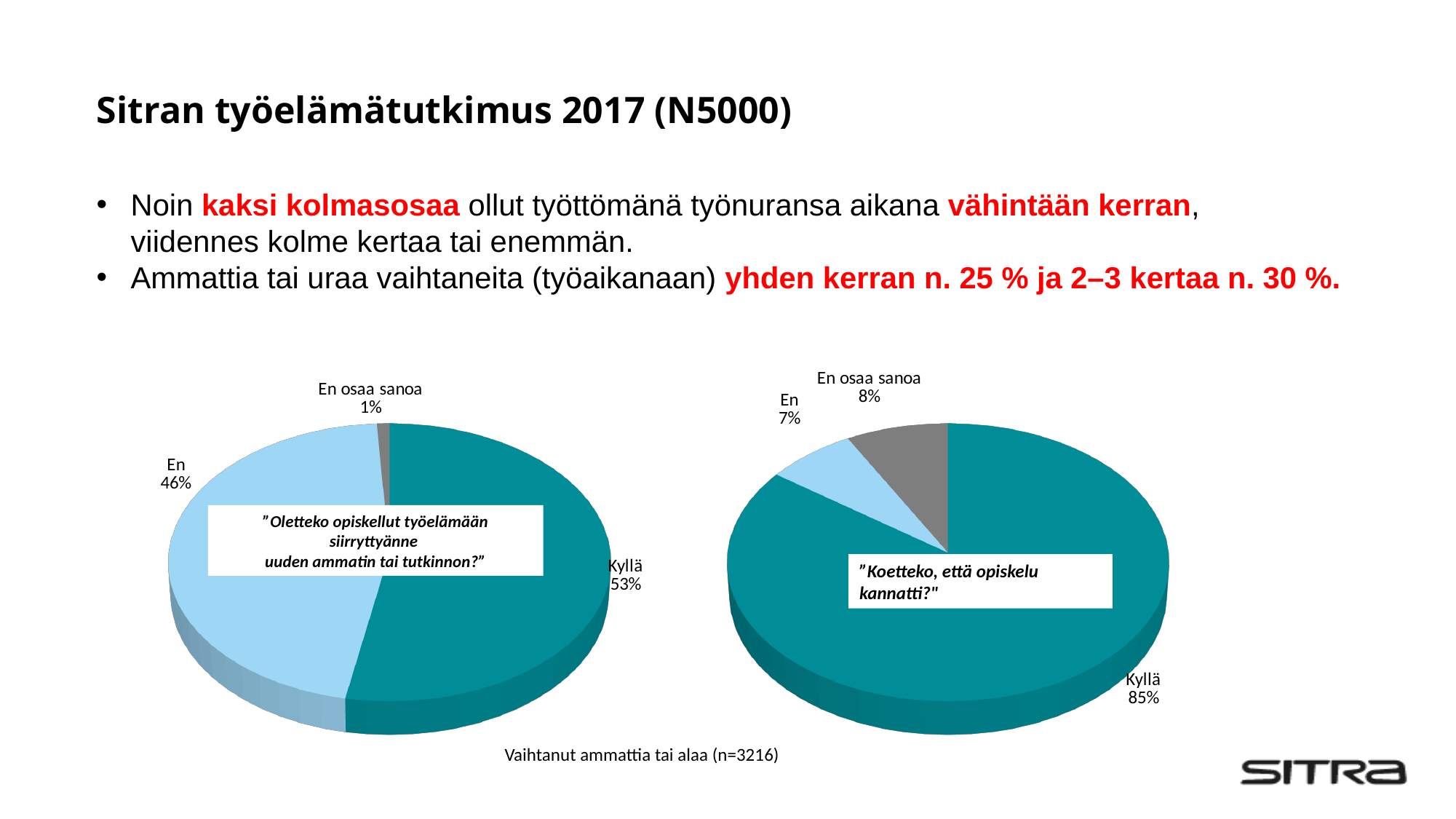
In the right pie chart, which is larger, the En slice or the En osaa sanoa slice? En osaa sanoa In the right pie chart, which category has the largest slice? Kyllä In the right pie chart, what share is labelled En osaa sanoa? 8% How many slices does the right pie chart have? 3 In the right pie chart ("Koetteko, että opiskelu kannatti?"), what share is labelled Kyllä? 85% In the left pie chart, which category has the smallest slice? En osaa sanoa In the left pie chart, what share is labelled En? 46% What type of chart is used on the left side of the slide? Pie chart In the left pie chart ("Oletteko opiskellut työelämään siirryttyänne uuden ammatin tai tutkinnon?"), what share is labelled Kyllä? 53% In the left pie chart, what is the difference in percentage points between Kyllä and En? 7 In the left pie chart, what share is labelled En osaa sanoa? 1% In the right pie chart, what share is labelled En? 7%